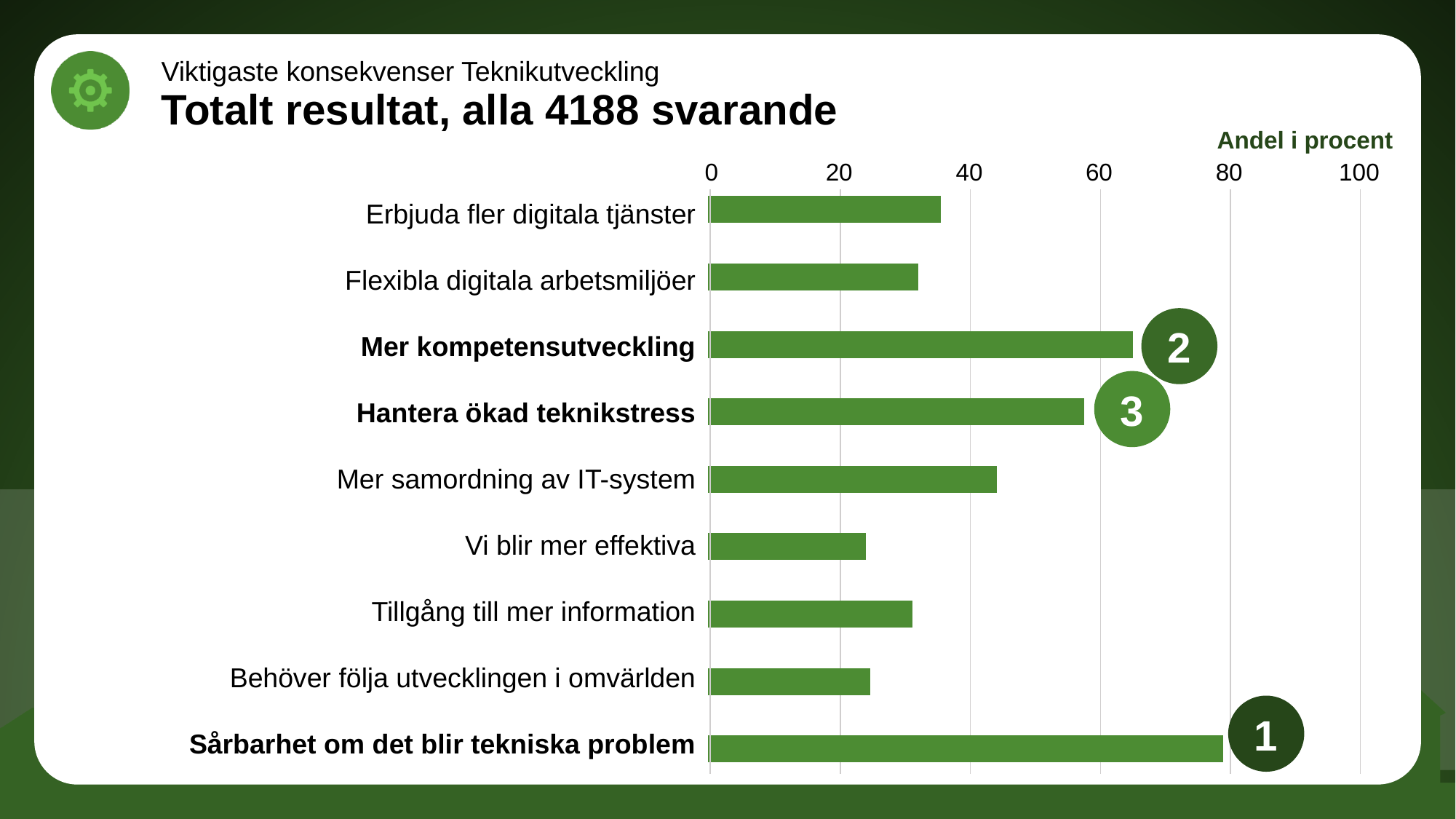
Is the value for Erbjuda fler digitala tjänster greater or less than 40? less Which category has the highest value in the chart? Sårbarhet om det blir tekniska problem Is the value for Mer samordning av IT-system greater or less than 40? greater How many categories are plotted in the chart? 9 Which is larger, the value for Mer kompetensutveckling or the value for Hantera ökad teknikstress? Mer kompetensutveckling Which category is marked with the circled number 1 in the chart? Sårbarhet om det blir tekniska problem Is the value for Sårbarhet om det blir tekniska problem greater or less than 60? greater Which is larger, the value for Mer samordning av IT-system or the value for Tillgång till mer information? Mer samordning av IT-system What label is shown above the horizontal axis of the chart? Andel i procent What kind of chart is shown on the slide? Bar chart